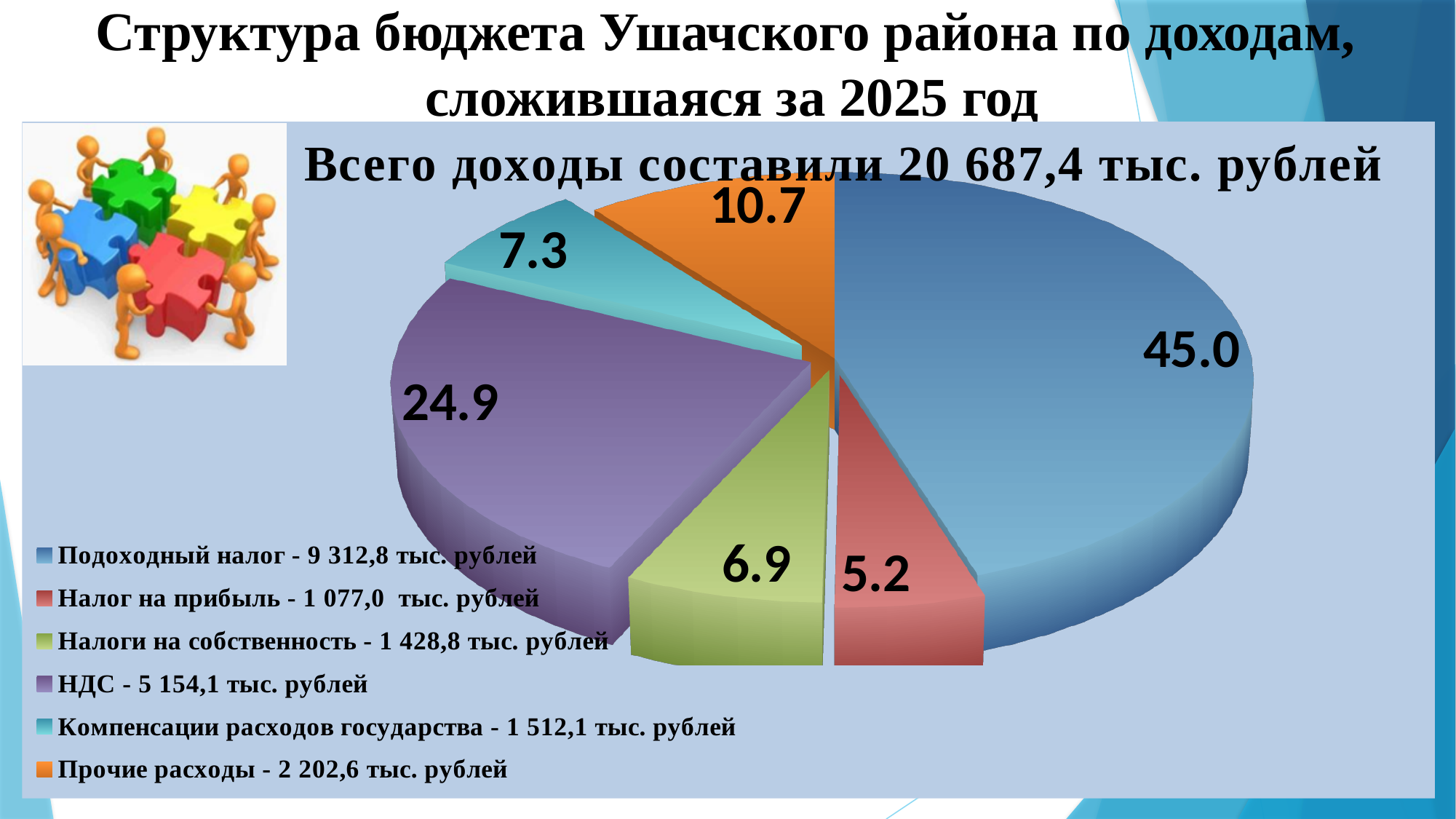
What is the difference between the data labels for Подоходный налог and НДС? 20.1 What kind of chart is shown on the slide? pie chart Which slice is larger: Налоги на собственность or Компенсации расходов государства? Компенсации расходов государства According to the legend, what amount is given for НДС? 5 154,1 тыс. рублей What is the data label on the slice for НДС? 24.9 How many slices does the pie chart have? 6 Which category has the smallest slice of the pie? Налог на прибыль What is the data label on the slice for Подоходный налог? 45.0 Which category has the largest slice of the pie? Подоходный налог What is the data label on the slice for Прочие расходы? 10.7 What is the data label on the slice for Налог на прибыль? 5.2 What total income is stated in the chart title? 20 687,4 тыс. рублей